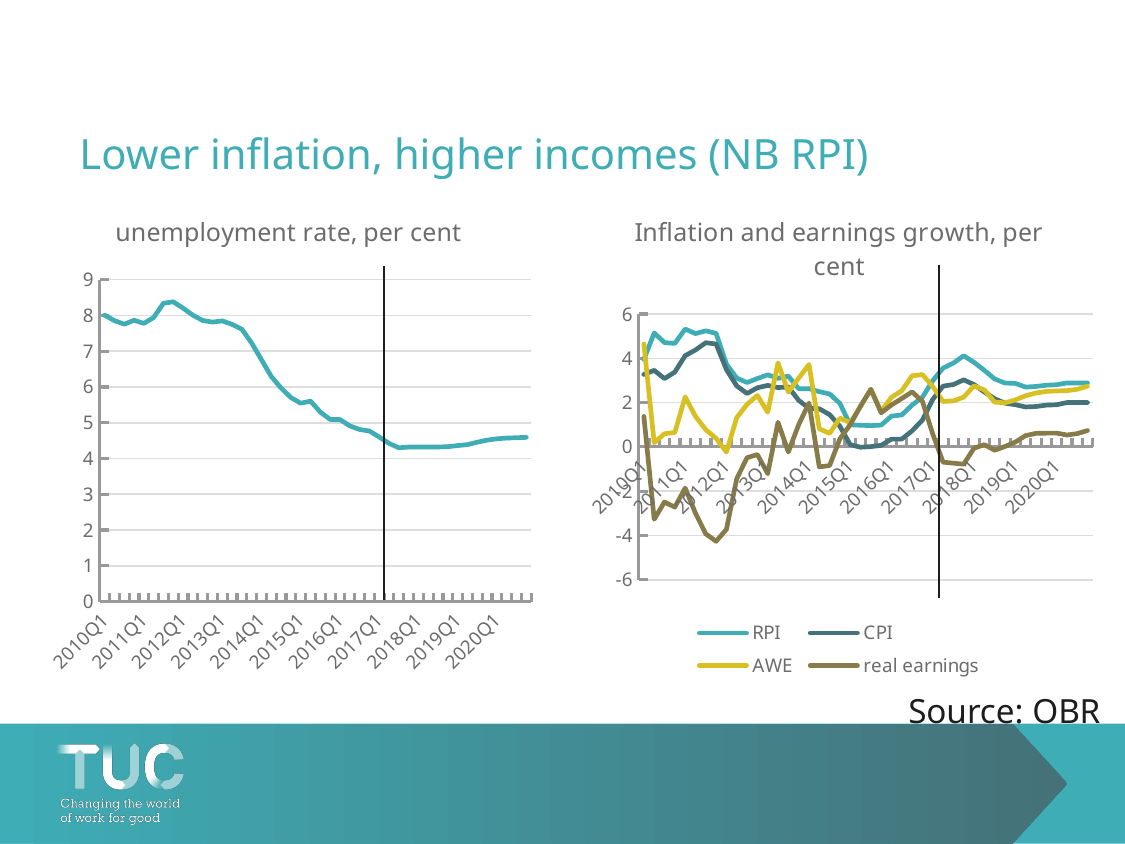
What kind of chart is the 'unemployment rate, per cent' chart on the left? line chart In the 'Inflation and earnings growth, per cent' chart, which is larger at 2011Q1, RPI or CPI? RPI In the 'unemployment rate, per cent' chart, is the unemployment rate at 2012Q1 greater or less than 8? greater In the 'unemployment rate, per cent' chart, is the value at 2010Q1 greater or less than 7? greater In the 'Inflation and earnings growth, per cent' chart, which series has the lowest value around 2012Q1? real earnings In the 'unemployment rate, per cent' chart, is the value at 2018Q1 greater or less than 5? less What is the title of the chart on the right of the slide? Inflation and earnings growth, per cent What are the series named in the legend of the 'Inflation and earnings growth, per cent' chart? RPI, CPI, AWE, real earnings In the 'unemployment rate, per cent' chart, does the unemployment rate overall rise or fall between 2010Q1 and 2018Q1? fall How many series does the legend of the 'Inflation and earnings growth, per cent' chart list? 4